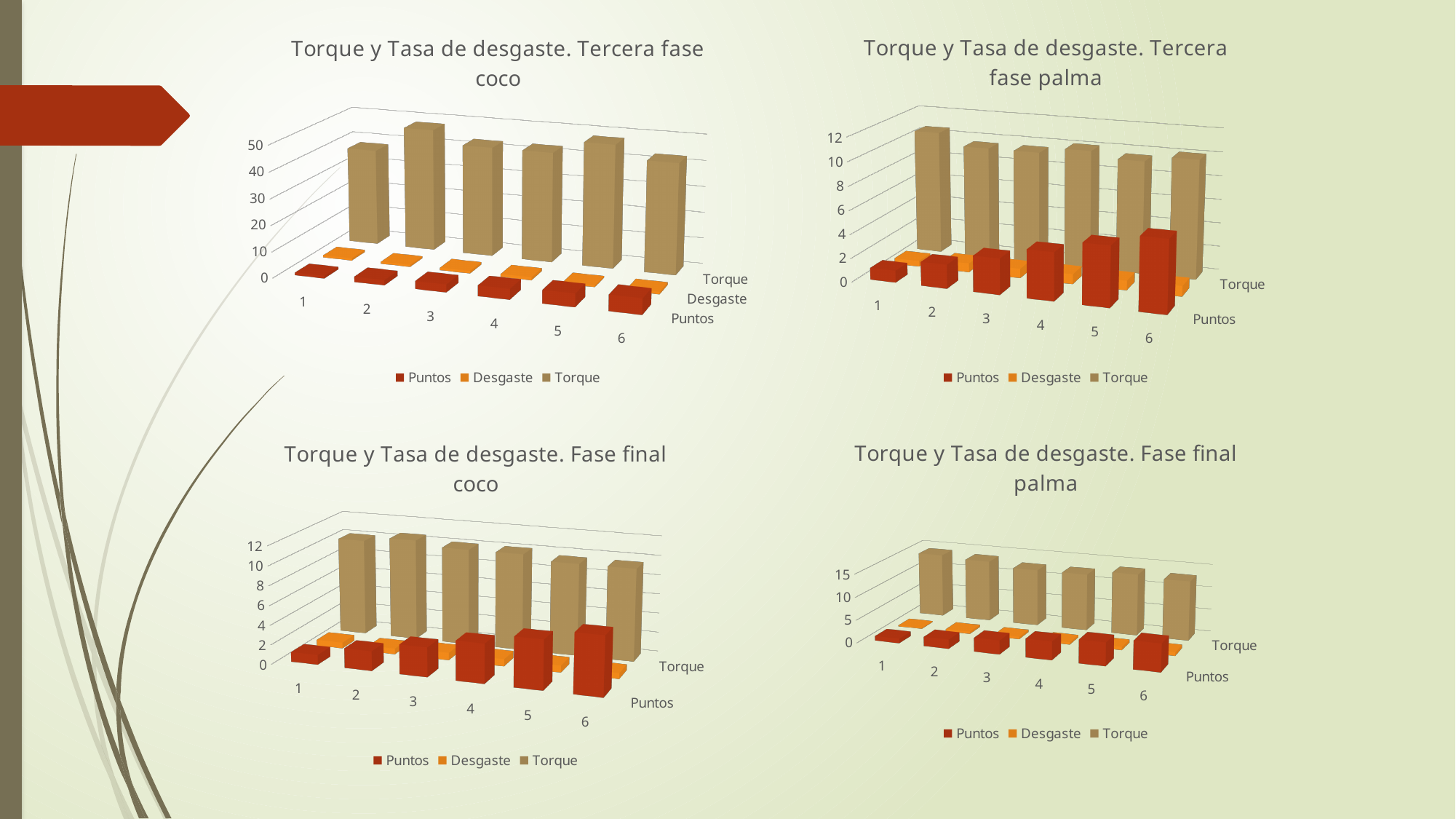
How many categories are shown on the x axis of the 'Torque y Tasa de desgaste. Fase final coco' chart? 6 In the 'Torque y Tasa de desgaste. Fase final palma' chart, is the Torque value for category 1 greater or less than 10? greater In the 'Torque y Tasa de desgaste. Tercera fase coco' chart, is the Puntos value for category 1 greater or less than 10? less In the 'Torque y Tasa de desgaste. Tercera fase palma' chart, which has the larger Puntos value, category 1 or category 6? category 6 What is the title of the chart in the bottom-right of the slide? Torque y Tasa de desgaste. Fase final palma In the 'Torque y Tasa de desgaste. Tercera fase palma' chart, do the Puntos values rise or fall from category 1 to category 6? rise In the 'Torque y Tasa de desgaste. Tercera fase coco' chart, is the Torque value for category 2 greater or less than 30? greater In the 'Torque y Tasa de desgaste. Fase final coco' chart, do the Torque values rise or fall from category 1 to category 6? fall What kind of chart is the 'Torque y Tasa de desgaste. Tercera fase coco' chart? bar chart What are the legend entries of the 'Torque y Tasa de desgaste. Fase final palma' chart? Puntos, Desgaste, Torque How many series does the legend of the 'Torque y Tasa de desgaste. Tercera fase palma' chart list? 3